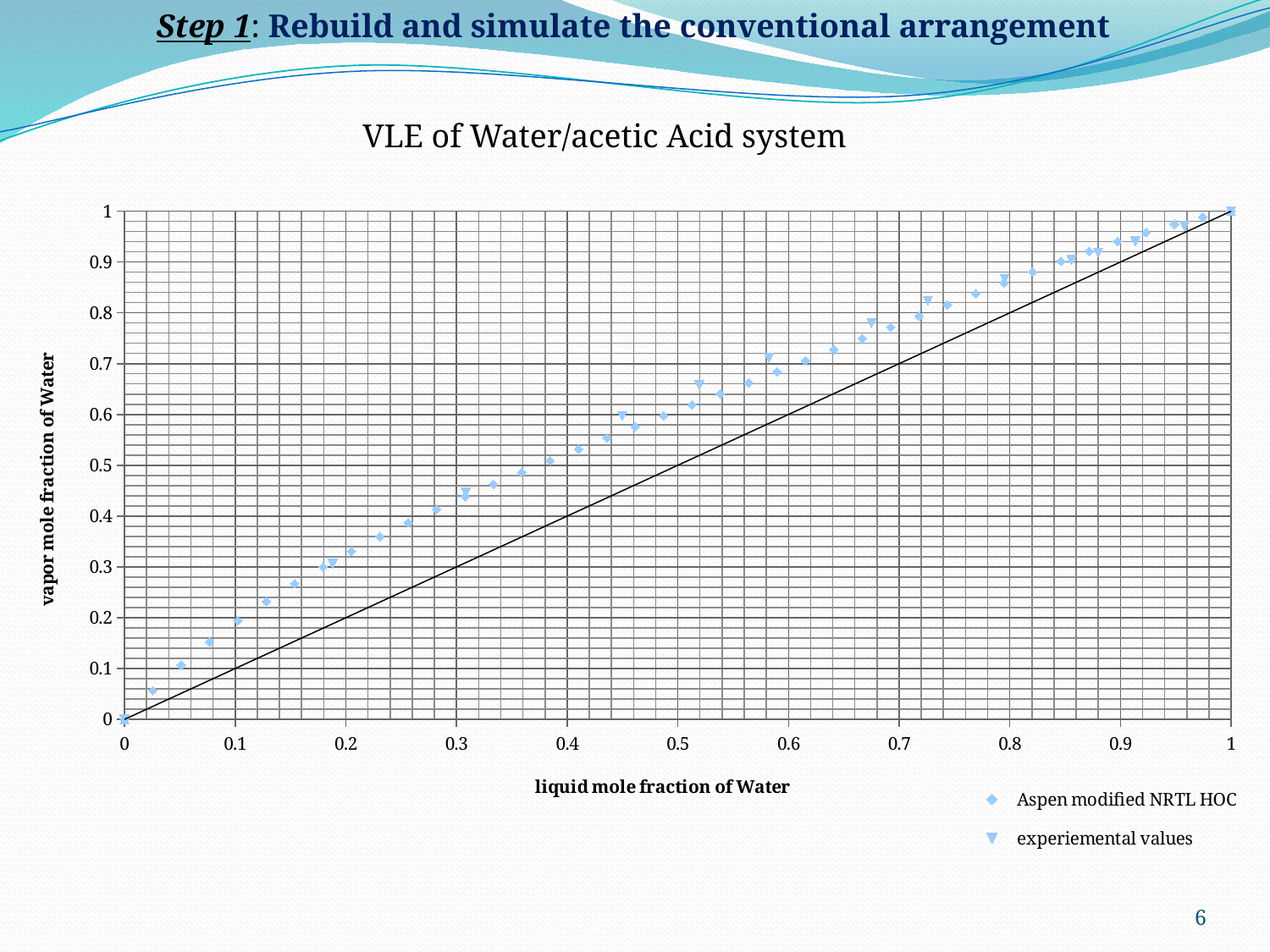
Which legend entry is shown with a triangle marker? experiemental values What is the title of the chart? VLE of Water/acetic Acid system What is the vapor mole fraction of Water when the liquid mole fraction of Water is 0? 0 Do the plotted data points lie above or below the diagonal straight line? above How many series does the legend list? 2 Is the plotted vapor mole fraction higher at a liquid mole fraction of 0.3 or at 0.6? 0.6 At a liquid mole fraction of Water of 0.1, is the plotted vapor mole fraction greater or less than 0.1? greater What is the vapor mole fraction of Water when the liquid mole fraction of Water is 1? 1 At a liquid mole fraction of Water of 0.8, is the plotted vapor mole fraction greater or less than 0.9? less At a liquid mole fraction of Water of 0.5, is the plotted vapor mole fraction greater or less than 0.5? greater What kind of chart is shown on the slide? scatter chart Do the plotted vapor mole fraction values rise or fall as the liquid mole fraction of Water increases? rise